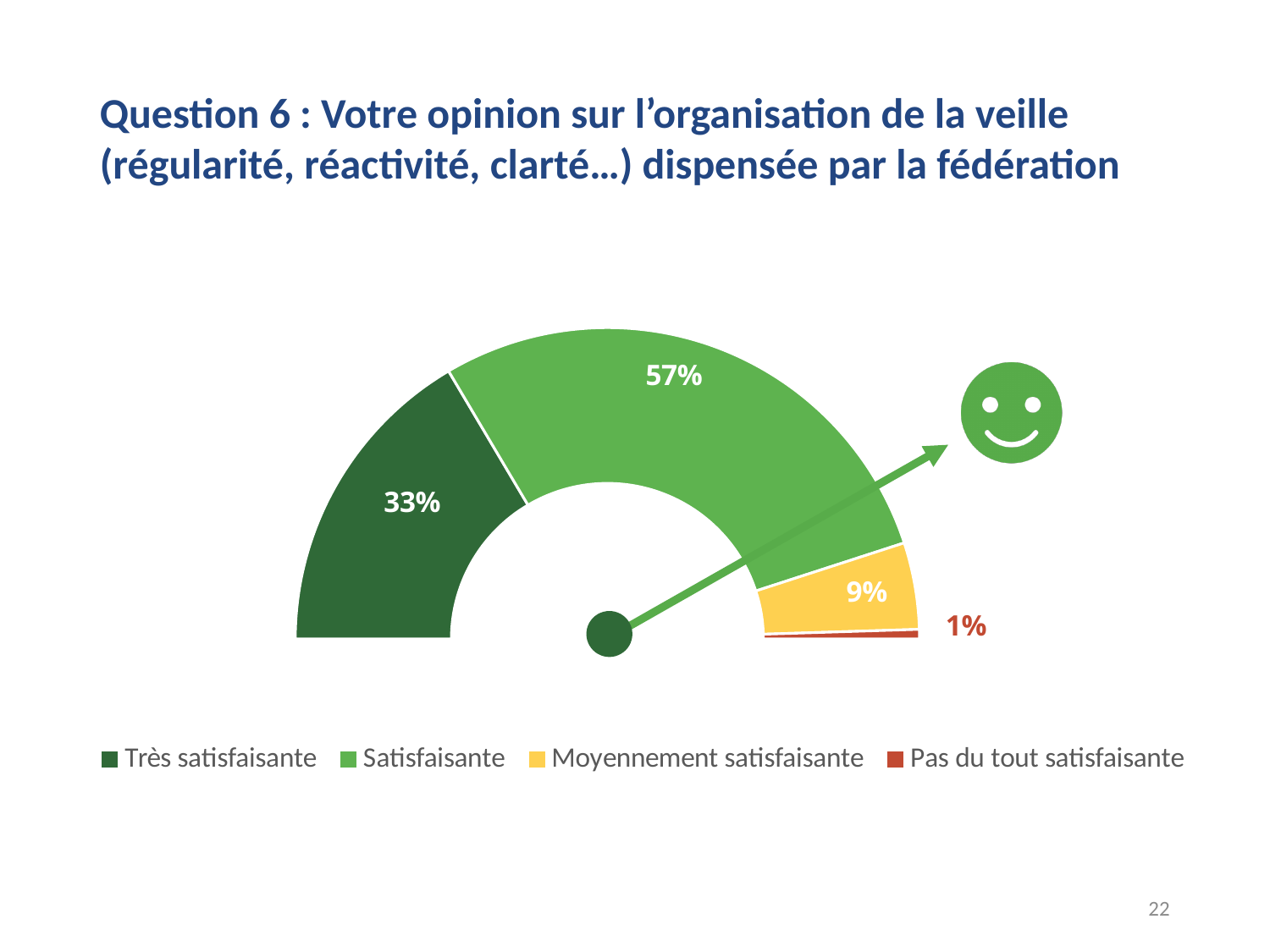
What colour represents "Moyennement satisfaisante" in the chart? Yellow What colour represents "Pas du tout satisfaisante" in the chart? Red What is the combined percentage of "Très satisfaisante" and "Satisfaisante"? 90% What percentage of respondents answered "Satisfaisante"? 57% What is the difference in percentage points between "Satisfaisante" and "Très satisfaisante"? 24 Which response category has the largest share? Satisfaisante How many response categories does the legend list? 4 What percentage of respondents answered "Pas du tout satisfaisante"? 1% What percentage of respondents answered "Moyennement satisfaisante"? 9% Which response category has the smallest share? Pas du tout satisfaisante What percentage of respondents answered "Très satisfaisante"? 33% Which is larger: the share for "Moyennement satisfaisante" or for "Pas du tout satisfaisante"? Moyennement satisfaisante